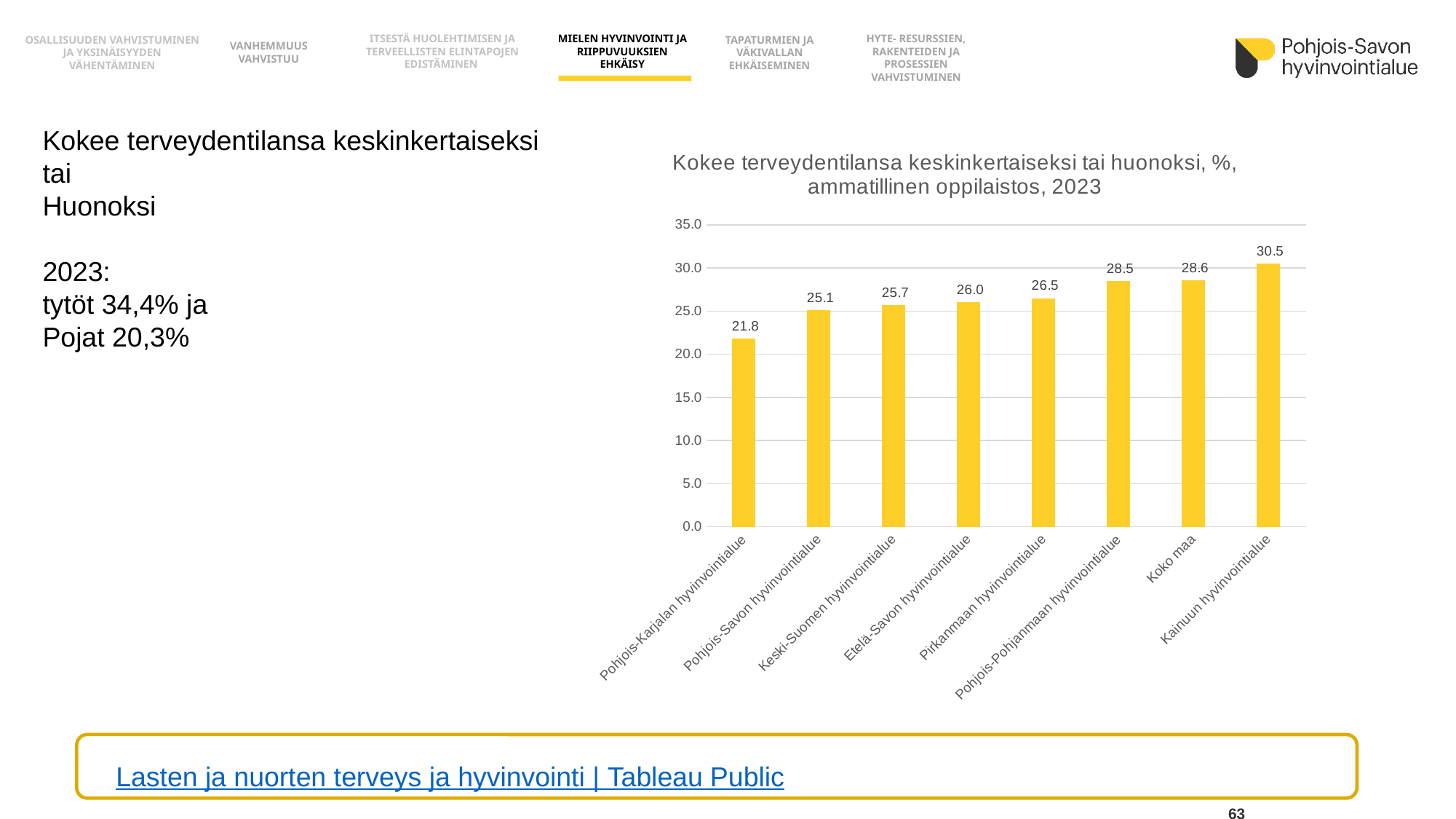
Do the values rise or fall from left to right along the x axis? rise Is the value for Etelä-Savon hyvinvointialue greater or less than 25.0? greater What is the difference between the values for Kainuun hyvinvointialue and Pohjois-Karjalan hyvinvointialue? 8.7 What is the title of the chart? Kokee terveydentilansa keskinkertaiseksi tai huonoksi, %, ammatillinen oppilaistos, 2023 Which category has the highest value? Kainuun hyvinvointialue Which is larger, the value for Pirkanmaan hyvinvointialue or the value for Pohjois-Savon hyvinvointialue? Pirkanmaan hyvinvointialue Which category has the lowest value? Pohjois-Karjalan hyvinvointialue How many categories are shown on the x axis? 8 What is the value for Pohjois-Savon hyvinvointialue? 25.1 What is the value for Pohjois-Karjalan hyvinvointialue? 21.8 What is the value for Koko maa? 28.6 What kind of chart is shown? bar chart